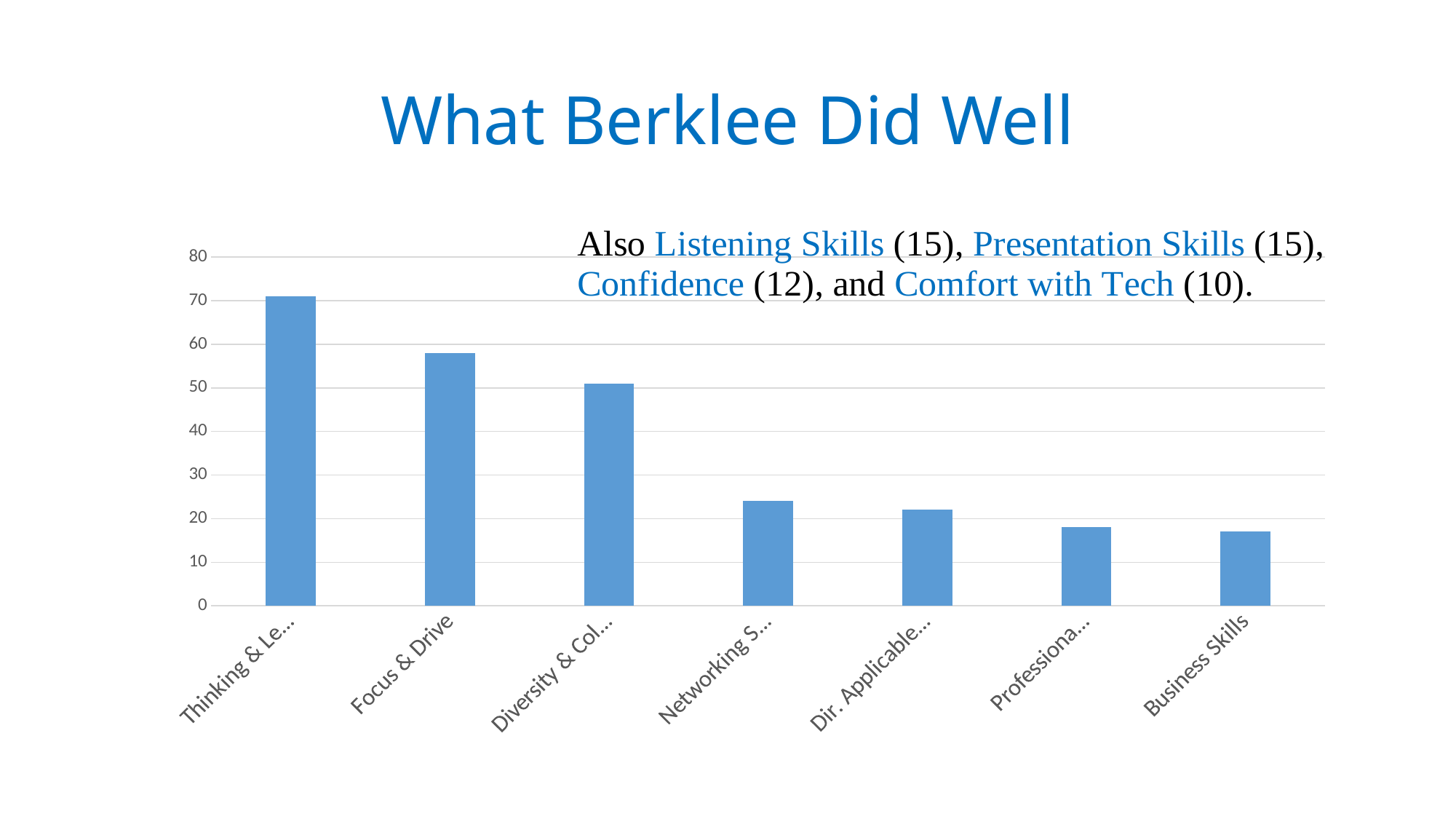
What kind of chart is shown on the slide? bar chart Do the bar values rise or fall from left to right along the x axis? fall Is the value of the third bar from the left (Diversity & Col...) greater or less than 40? greater Is the value for Focus & Drive greater or less than 50? greater According to the text beside the chart, what value is given for Confidence? 12 Is the value of the first bar (Thinking & Le...) greater or less than 60? greater How many bars are plotted in the chart? 7 Which category has the highest bar in the chart? Thinking & Le... (the first bar) Which is larger, the value for Focus & Drive or the value for Business Skills? Focus & Drive What is the title of the slide containing the chart? What Berklee Did Well